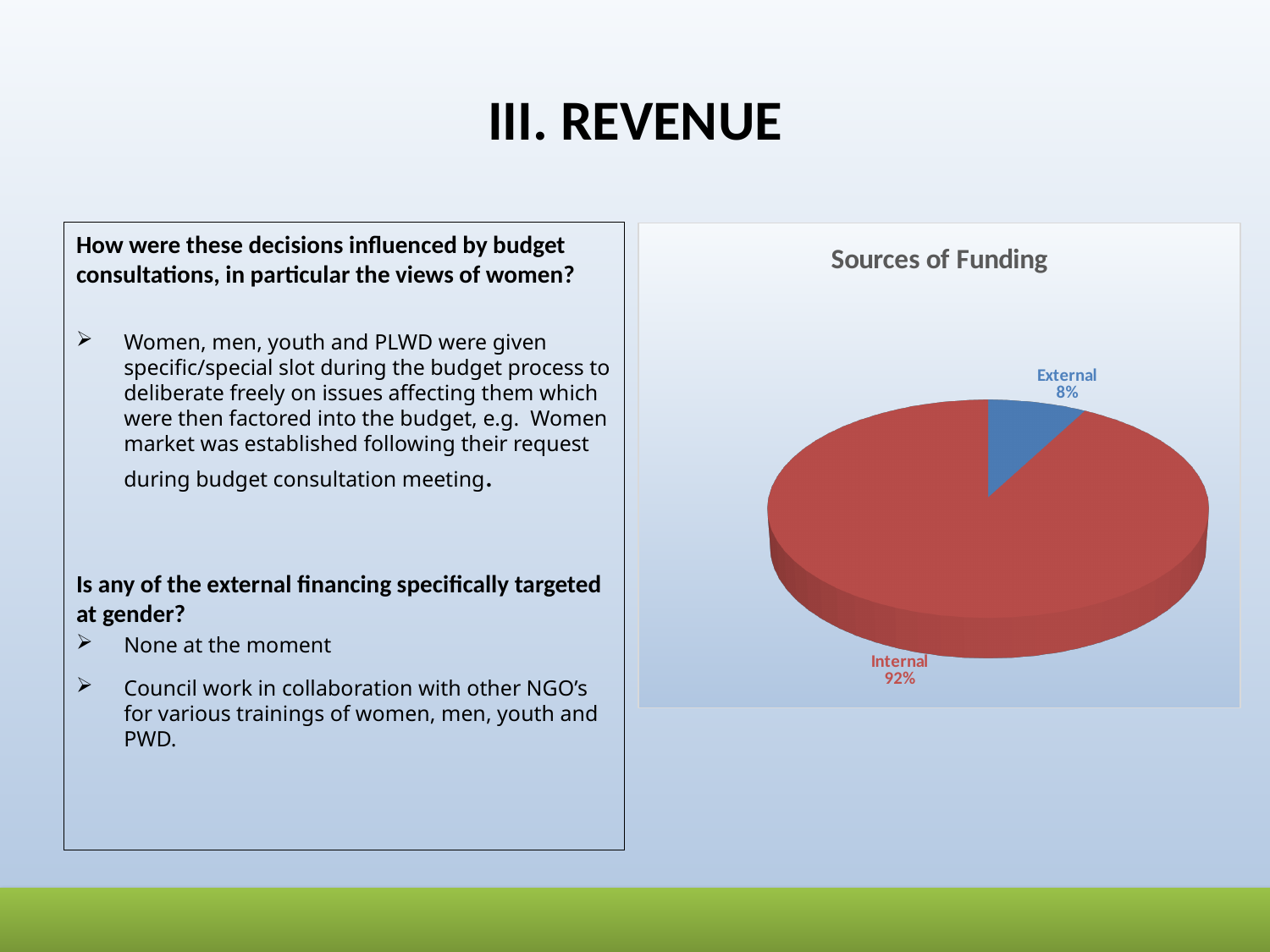
What share of funding is Internal? 92% Which source of funding has the smallest share? External What is the title of the chart? Sources of Funding Which source of funding has the largest share? Internal Which is larger, the Internal share or the External share? Internal What is the total of the Internal and External shares? 100% How many slices does the pie chart have? 2 What share of funding is External? 8% What is the difference in percentage points between the Internal and External shares? 84 What colour is the Internal slice of the pie chart? red What kind of chart is shown on the slide? pie chart